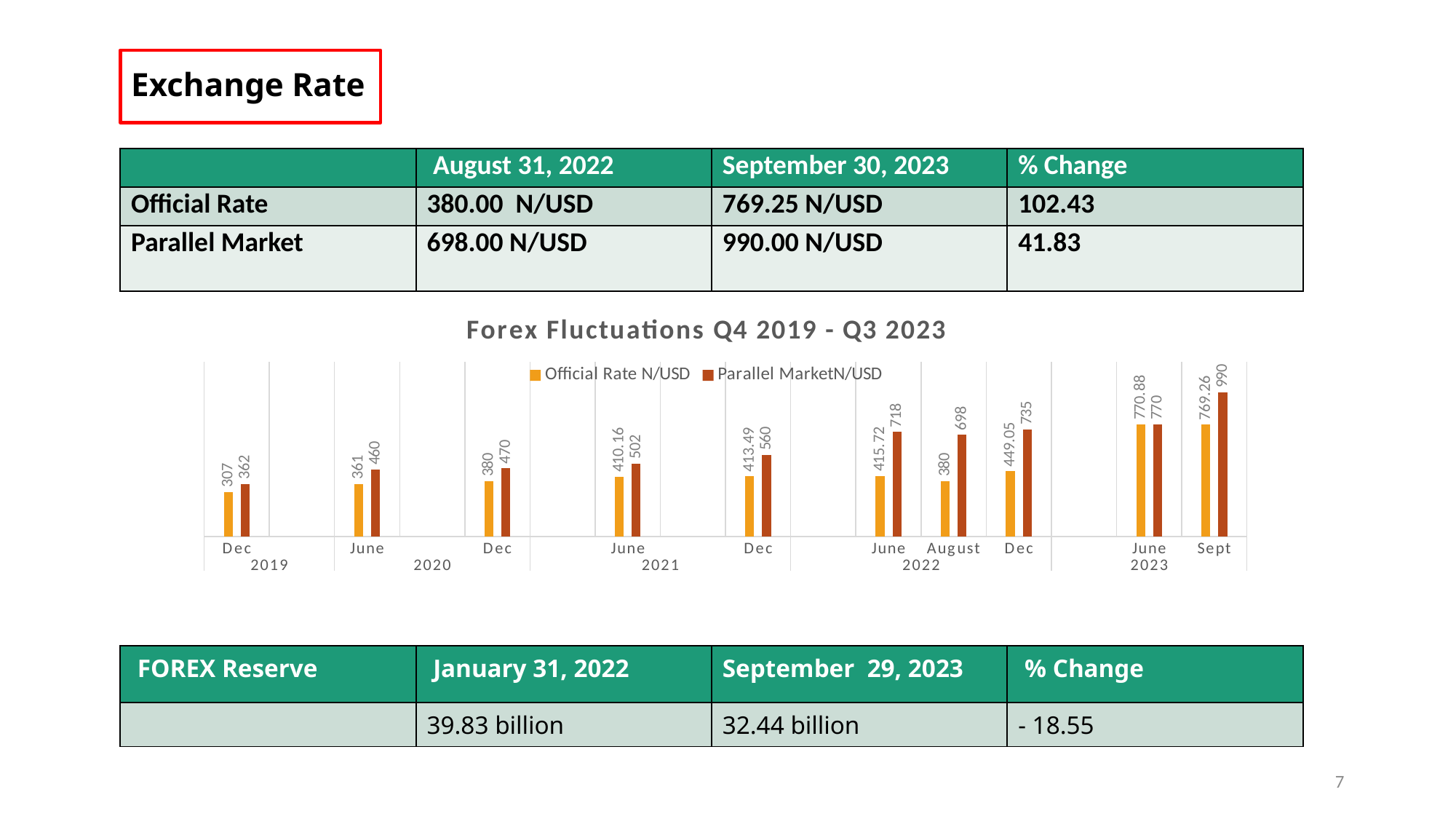
In the Forex Fluctuations chart, which period has the highest Parallel Market N/USD value? Sept 2023 In the Forex Fluctuations chart, which period has the lowest Official Rate N/USD value? Dec 2019 In the Forex Fluctuations chart, what is the difference between the Parallel Market and Official Rate values for Sept 2023? 220.74 What is the Parallel Market N/USD value for Sept 2023 in the Forex Fluctuations chart? 990 What is the Official Rate N/USD value for June 2023 in the Forex Fluctuations chart? 770.88 What is the Official Rate N/USD value for Dec 2019 in the Forex Fluctuations chart? 307 How many time periods are shown on the x axis of the Forex Fluctuations chart? 10 In the Forex Fluctuations chart, what is the difference between the Parallel Market and Official Rate values for June 2022? 302.28 What type of chart is the Forex Fluctuations Q4 2019 - Q3 2023 chart? Bar chart What is the Parallel Market N/USD value for August 2022 in the Forex Fluctuations chart? 698 How many series does the legend of the Forex Fluctuations chart list? 2 In the Forex Fluctuations chart, which is larger for Dec 2021: the Official Rate or the Parallel Market value? Parallel Market